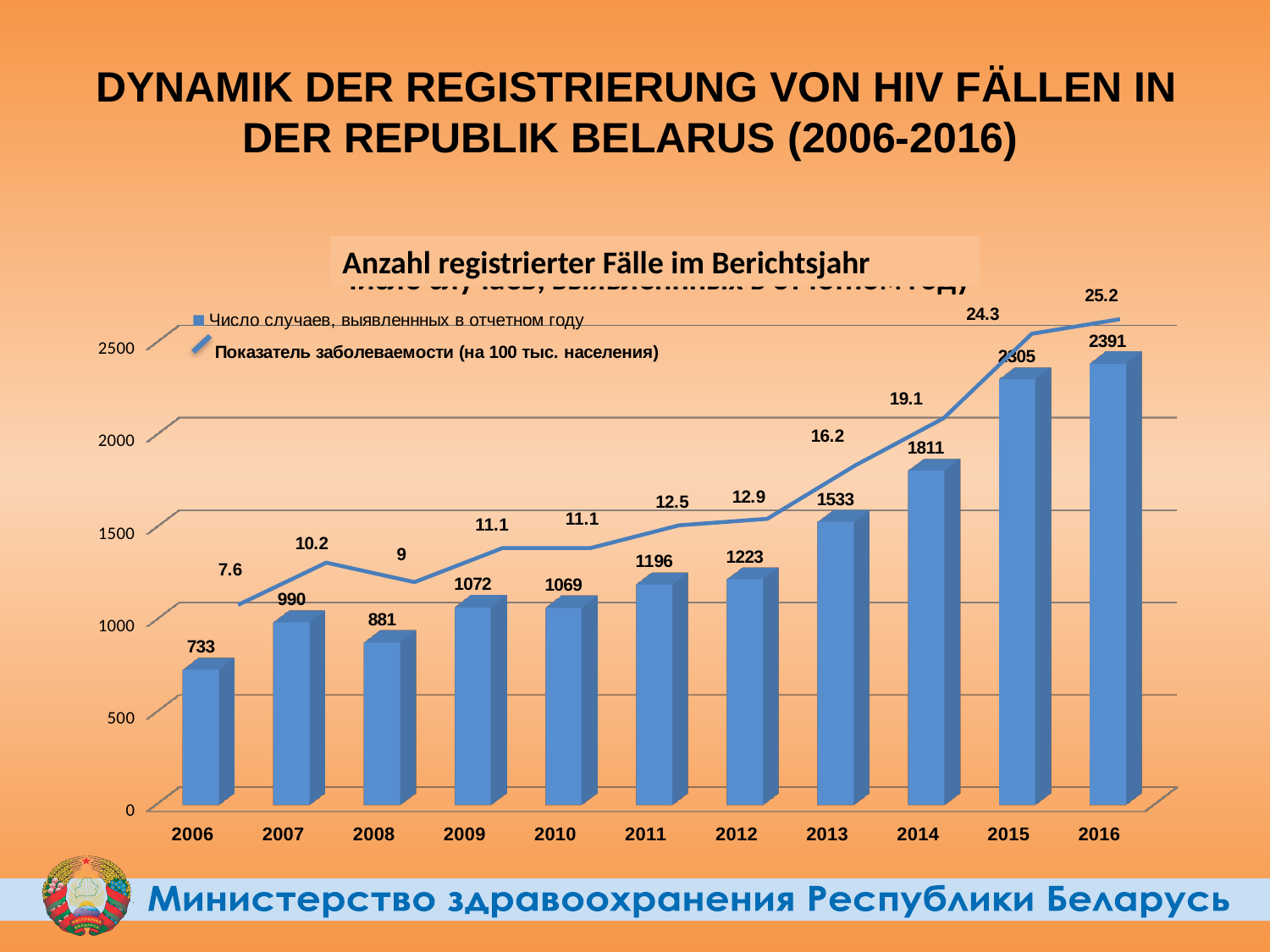
Which year has the highest number of registered cases? 2016 What is the number of registered cases shown for 2013? 1533 What incidence rate (per 100 thousand population) is shown on the line for 2016? 25.2 Which year has more registered cases, 2007 or 2008? 2007 How many series does the legend list? 2 What kind of chart is shown on the slide? Combined bar and line chart Which year has the lowest number of registered cases? 2006 What is the difference in registered cases between 2016 and 2015? 86 Do the registered case numbers generally rise or fall from 2006 to 2016? Rise How many years are shown on the x axis? 11 How many registered HIV cases does the bar for 2006 show? 733 What incidence rate value is labelled on the line for 2008? 9